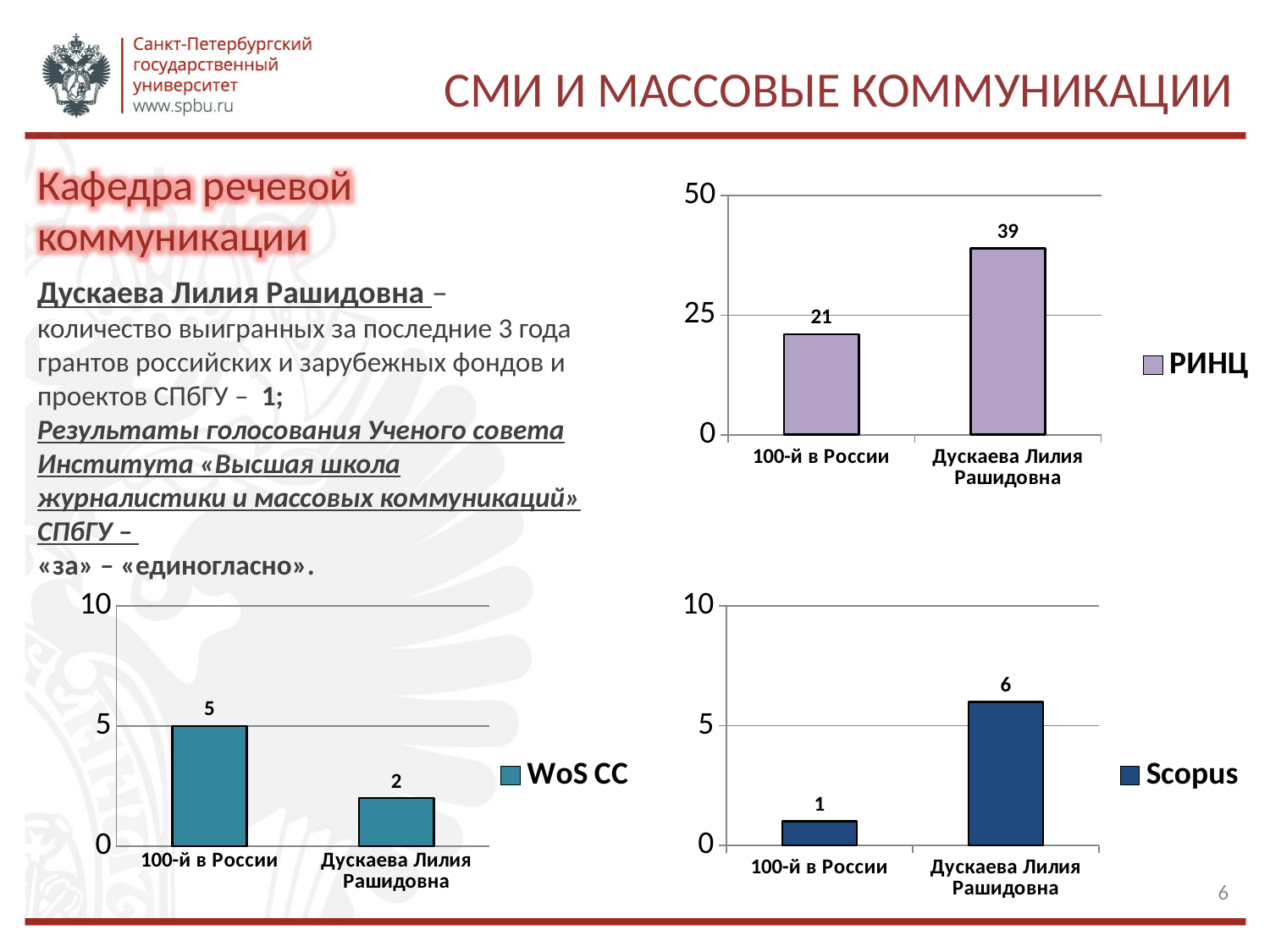
In the РИНЦ chart (top right), what is the value for 100-й в России? 21 In the Scopus chart (bottom right), what is the difference between the values for Дускаева Лилия Рашидовна and 100-й в России? 5 In the WoS CC chart (bottom left), which category has the higher value? 100-й в России In the WoS CC chart (bottom left), what is the value for 100-й в России? 5 In the WoS CC chart (bottom left), what is the value for Дускаева Лилия Рашидовна? 2 In the РИНЦ chart (top right), what is the difference between the values for Дускаева Лилия Рашидовна and 100-й в России? 18 In the Scopus chart (bottom right), what is the value for Дускаева Лилия Рашидовна? 6 How many categories are shown in the Scopus chart (bottom right)? 2 In the РИНЦ chart (top right), what is the value for Дускаева Лилия Рашидовна? 39 In the Scopus chart (bottom right), what is the value for 100-й в России? 1 In the РИНЦ chart (top right), is the value for Дускаева Лилия Рашидовна greater or less than 25? greater What kind of chart is the WoS CC chart (bottom left)? bar chart